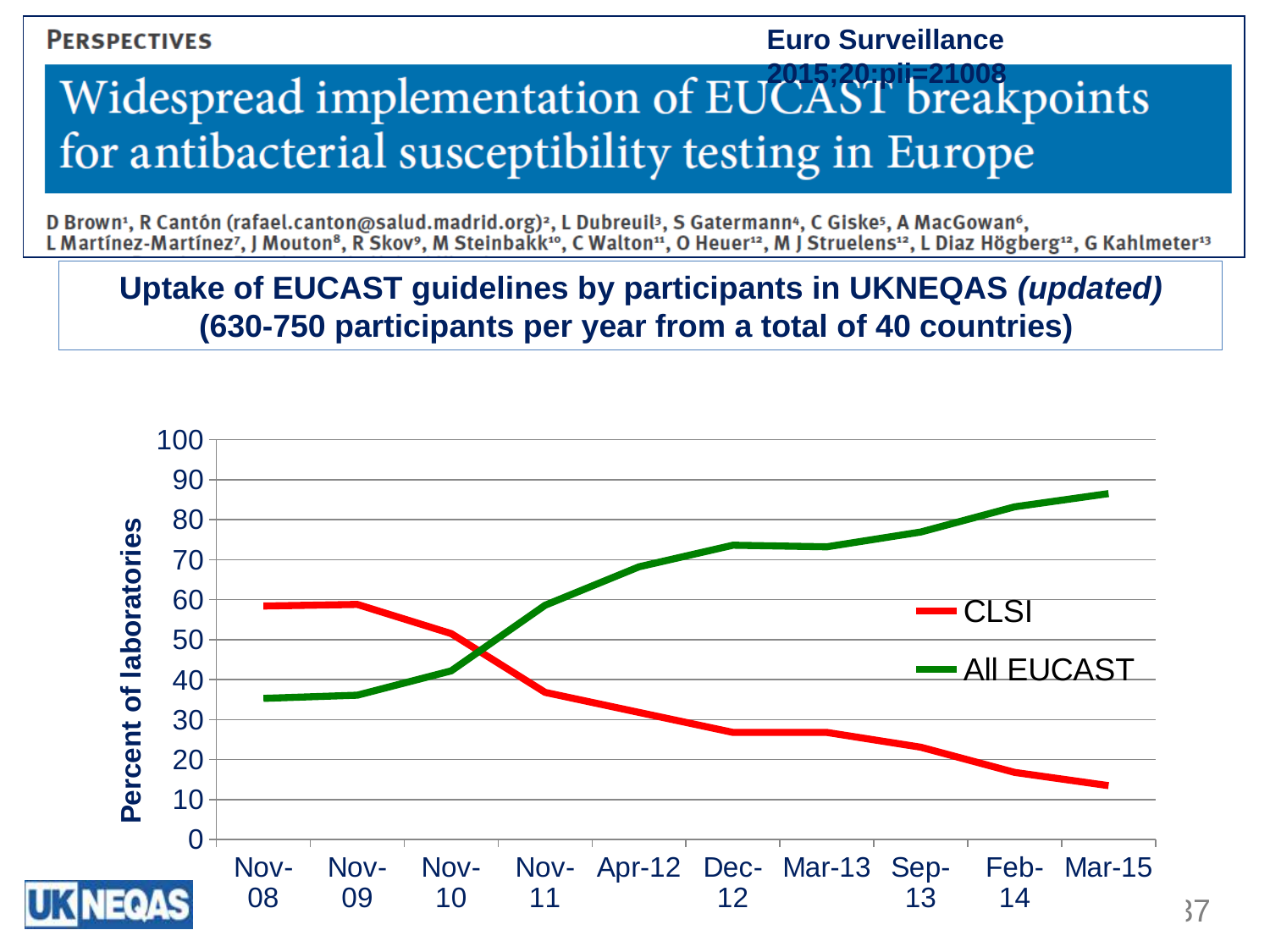
How many time points are shown on the x axis? 10 At Mar-15, which series has the larger value, CLSI or All EUCAST? All EUCAST Does the CLSI line rise or fall from Nov-08 to Mar-15? fall At which time point is the CLSI value lowest? Mar-15 Does the All EUCAST line rise or fall from Nov-08 to Mar-15? rise What is the label of the y axis? Percent of laboratories Is the All EUCAST value at Mar-15 greater or less than 80? greater Is the CLSI value at Mar-15 greater or less than 20? less At which time point is the All EUCAST value highest? Mar-15 How many series does the legend list? 2 At Nov-08, which series has the larger value, CLSI or All EUCAST? CLSI What kind of chart is shown on the slide? line chart